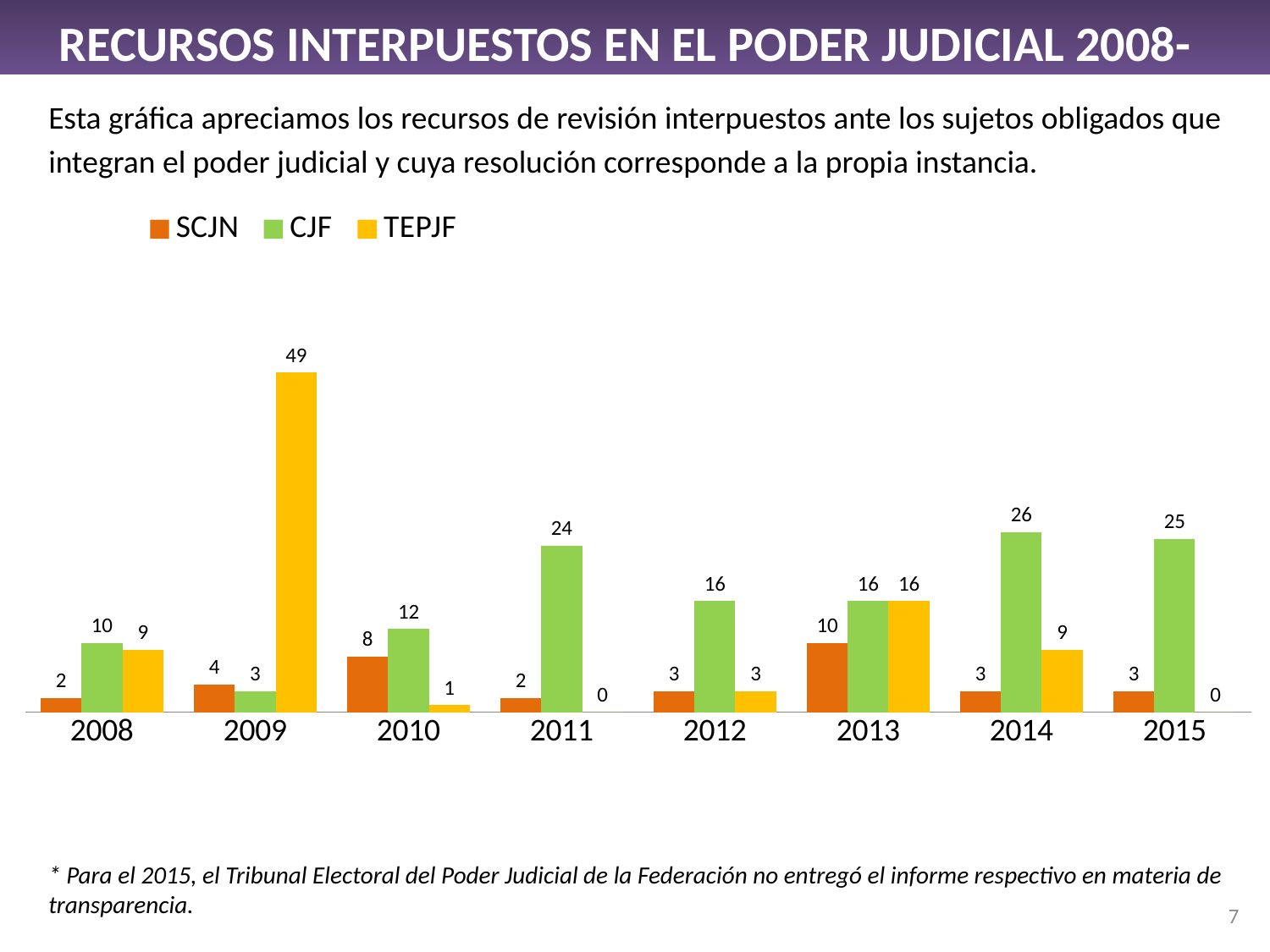
What is the value for SCJN in 2013? 10 What is the value for TEPJF in 2009? 49 How many series does the legend list? 3 In which year is the SCJN value lowest? 2008 and 2011 Which is larger in 2010, the SCJN value or the CJF value? CJF In which year is the CJF value highest? 2014 What is the value for CJF in 2014? 26 What is the difference between the CJF and SCJN values in 2011? 22 Does the CJF value rise or fall from 2012 to 2014? rise What kind of chart is shown on the slide? bar chart How many years are shown on the x axis? 8 Which colour represents TEPJF in the legend? yellow